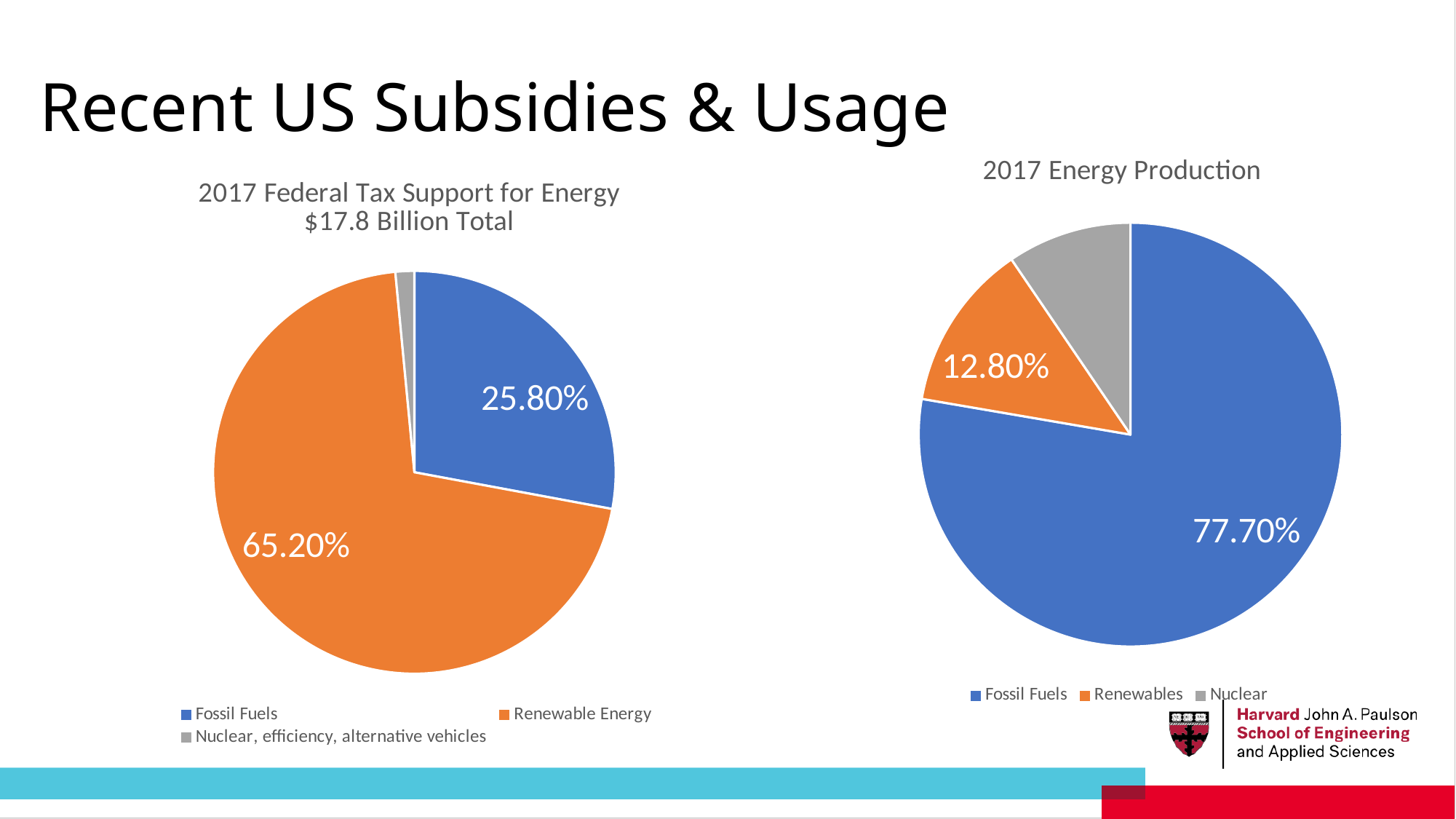
In the '2017 Energy Production' pie chart, how many percentage points larger is the Fossil Fuels share than the Renewables share? 64.90 percentage points Is the Fossil Fuels share larger in the '2017 Federal Tax Support for Energy' chart or in the '2017 Energy Production' chart? 2017 Energy Production In the '2017 Energy Production' pie chart, which category has the smallest slice? Nuclear In the '2017 Federal Tax Support for Energy' pie chart, which category has the smallest slice? Nuclear, efficiency, alternative vehicles How many categories does the legend of the '2017 Energy Production' pie chart list? 3 In the '2017 Federal Tax Support for Energy' pie chart, what share is labeled for Fossil Fuels? 25.80% What type of chart is used for '2017 Energy Production'? Pie chart In the '2017 Energy Production' pie chart, what share is labeled for Fossil Fuels? 77.70% In the '2017 Federal Tax Support for Energy' pie chart, what share is labeled for Renewable Energy? 65.20% In the '2017 Federal Tax Support for Energy' pie chart, which category has the largest slice? Renewable Energy In the '2017 Federal Tax Support for Energy' pie chart, how many percentage points larger is the Renewable Energy share than the Fossil Fuels share? 39.40 percentage points In the '2017 Energy Production' pie chart, what share is labeled for Renewables? 12.80%